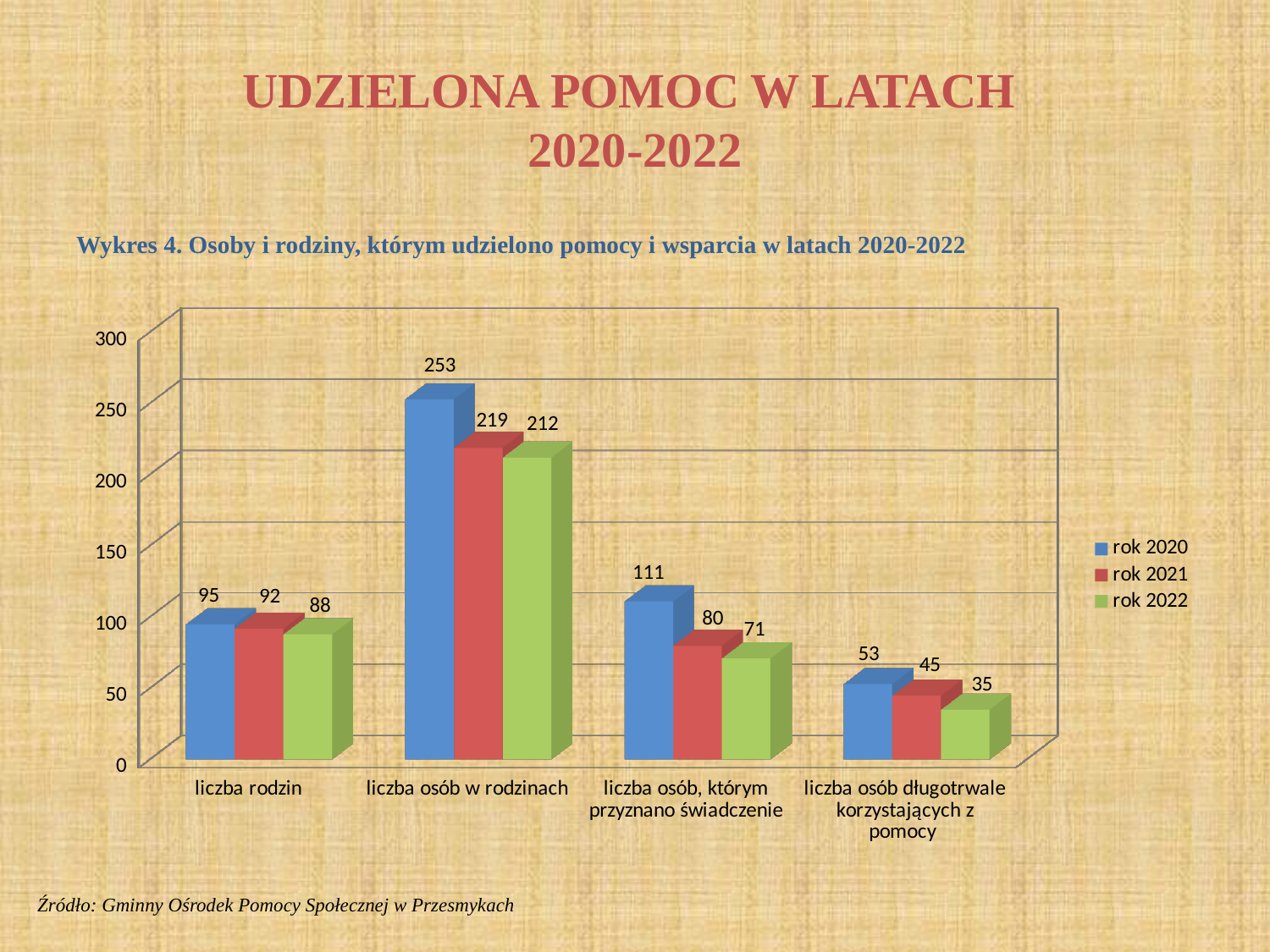
Which series is shown in green in the legend? rok 2022 What is the difference between the 'rok 2020' and 'rok 2022' values for 'liczba osób, którym przyznano świadczenie'? 40 What is the value for 'liczba osób w rodzinach' in the 'rok 2020' series? 253 Which is larger for 'liczba osób w rodzinach': the 'rok 2021' value or the 'rok 2022' value? rok 2021 Which category has the lowest value in the 'rok 2022' series? liczba osób długotrwale korzystających z pomocy Is the 'rok 2020' value for 'liczba osób, którym przyznano świadczenie' greater or less than 100? greater What is the value for 'liczba rodzin' in the 'rok 2022' series? 88 What is the value for 'liczba osób długotrwale korzystających z pomocy' in the 'rok 2021' series? 45 How many series does the legend list? 3 How many categories are shown on the x axis? 4 Which category has the highest value in the 'rok 2021' series? liczba osób w rodzinach What kind of chart is shown on the slide? bar chart